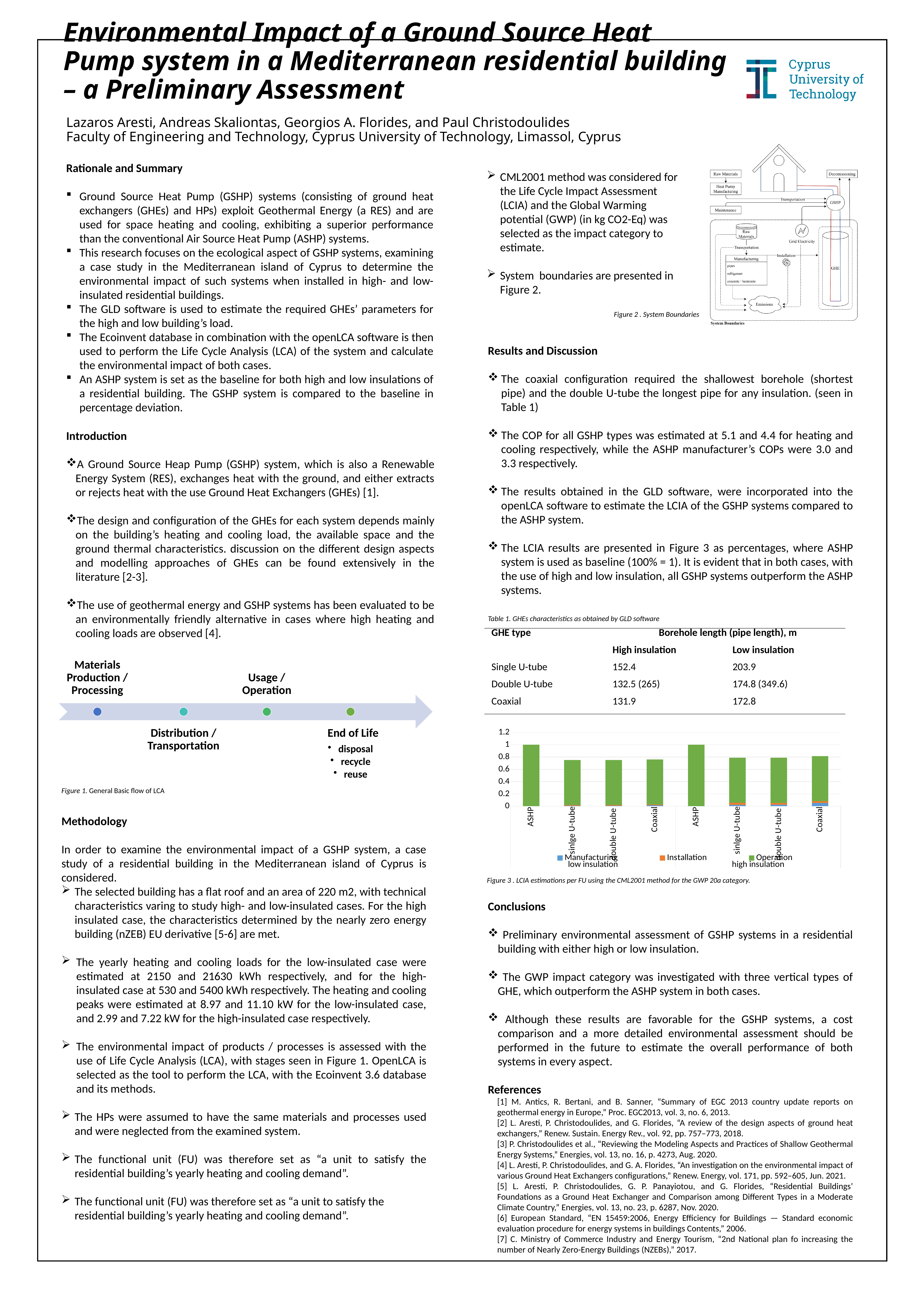
In Figure 3, which is larger under high insulation: ASHP or double U-tube? ASHP In Figure 3, which series makes up the largest part of every bar? Operation In Figure 3, is the value for ASHP under low insulation greater or less than 0.8? greater In Figure 3, which bar is the highest within the low insulation group? ASHP In Figure 3, is the value for Coaxial under high insulation greater or less than 0.6? greater In Figure 3, is the value for single U-tube under low insulation greater or less than 0.8? less What kind of chart is Figure 3? bar chart How many bars are plotted in Figure 3? 8 What are the three series listed in the legend of Figure 3? Manufacturing, Installation, Operation How many series does the legend of Figure 3 list? 3